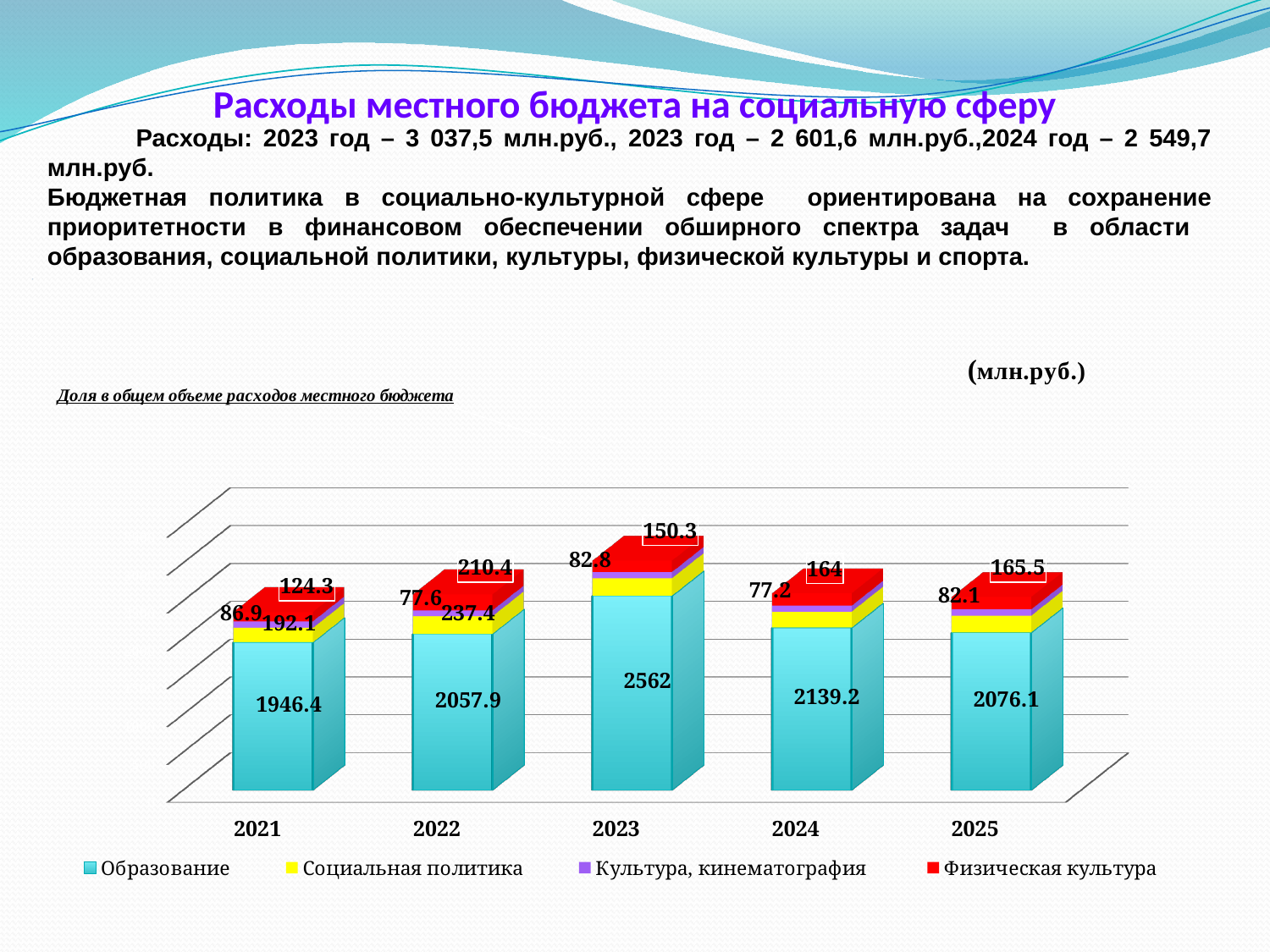
How many series does the chart legend list? 4 What is the value for Образование in 2021? 1946.4 Which year has the larger value for Образование, 2022 or 2025? 2025 What is the value for Образование in 2024? 2139.2 In which year is the value for Образование the highest? 2023 In which year is the value for Образование the lowest? 2021 What is the difference between the Образование values for 2023 and 2024? 422.8 What kind of chart is shown on the slide? Stacked bar chart Does the value for Образование rise or fall from 2021 to 2023? Rises Which colour represents Образование in the chart legend? Light blue (cyan) How many years are shown on the x axis of the chart? 5 What is the value for Образование in 2023? 2562